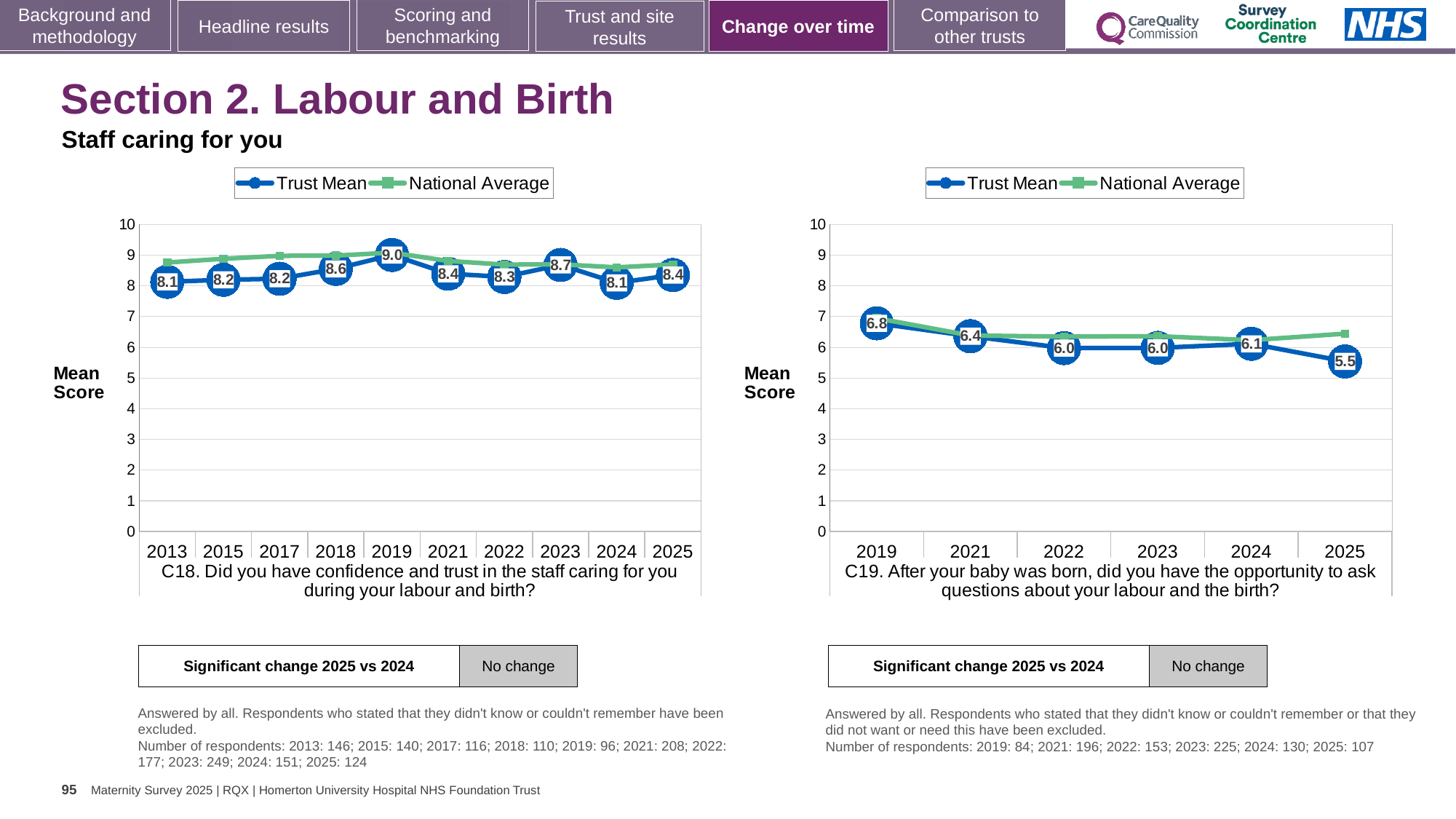
In the C18 chart (left), what is the difference between the Trust Mean scores for 2019 and 2024? 0.9 In the C19 chart (right), what is the Trust Mean score for 2019? 6.8 In the C18 chart (left), what is the Trust Mean score for 2025? 8.4 In the C18 chart (left), how many years are plotted on the x axis? 10 In the C19 chart (right), which is larger, the Trust Mean score for 2021 or for 2024? 2021 In the C18 chart (left), which year has the highest Trust Mean score? 2019 How many series does the legend of the C19 chart (right) list? 2 In the C19 chart (right), which year has the lowest Trust Mean score? 2025 What type of chart is the C18 chart (left)? line chart In the C19 chart (right), is the Trust Mean score for 2025 greater or less than 6? less In the C18 chart (left), what is the Trust Mean score for 2019? 9.0 In the C19 chart (right), does the Trust Mean score generally rise or fall from 2019 to 2025? fall